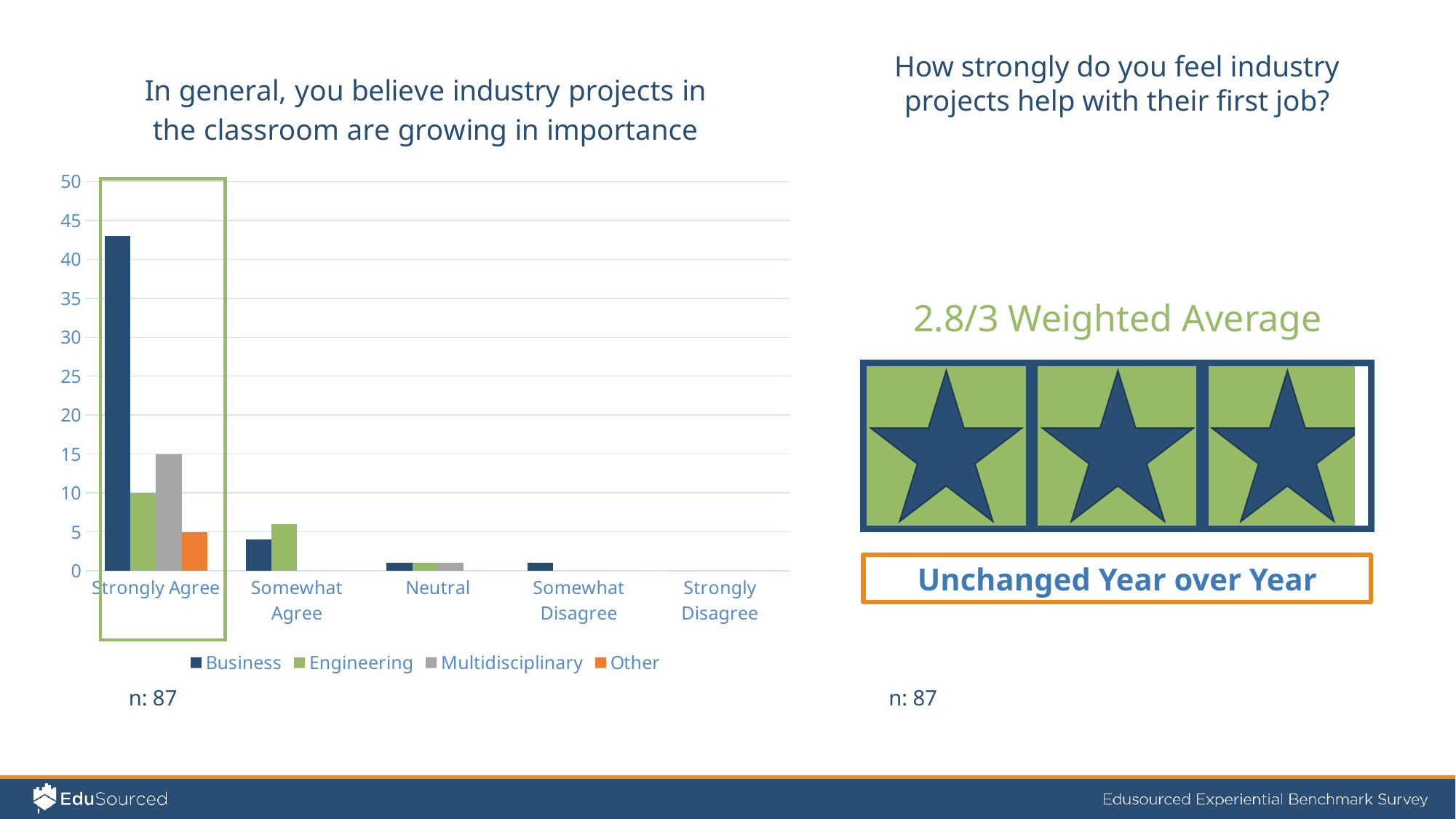
What is the difference between the Multidisciplinary and Engineering values for Strongly Agree? 5 How many response categories are shown on the x axis of the bar chart? 5 Is the Business value for Strongly Agree greater or less than 40? greater What is the Multidisciplinary value for Strongly Agree? 15 Is the Business value for Somewhat Agree greater or less than 10? less Which series has the highest value in the Strongly Agree category? Business What kind of chart is shown on the slide? bar chart What is the Other value for Strongly Agree? 5 How many series does the legend of the bar chart list? 4 Which category on the x axis has the highest Business value? Strongly Agree In the Somewhat Agree category, which is larger, Business or Engineering? Engineering What is the Engineering value for Strongly Agree? 10